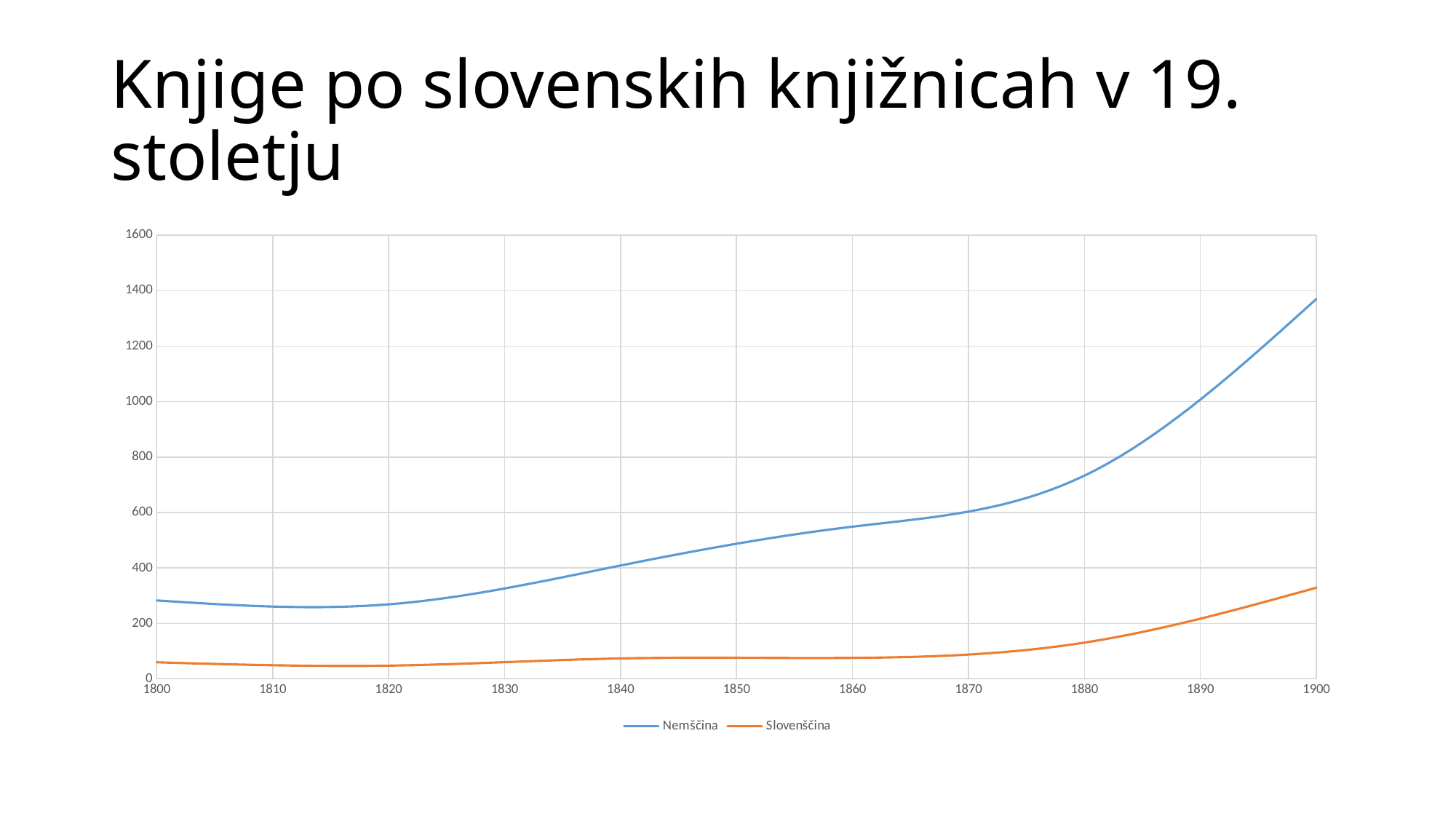
Which series has the higher value in 1900, Nemščina or Slovenščina? Nemščina Is the value for Slovenščina in 1900 greater or less than 200? greater Is the value for Nemščina in 1800 greater or less than 400? less Is the value for Nemščina in 1900 greater or less than 1200? greater Does the Slovenščina line rise or fall between 1870 and 1900? rise Which series is drawn in blue? Nemščina What kind of chart is shown on the slide? line chart What is the title of the slide containing the chart? Knjige po slovenskih knjižnicah v 19. stoletju How many series does the legend list? 2 How many year labels are shown on the x axis? 11